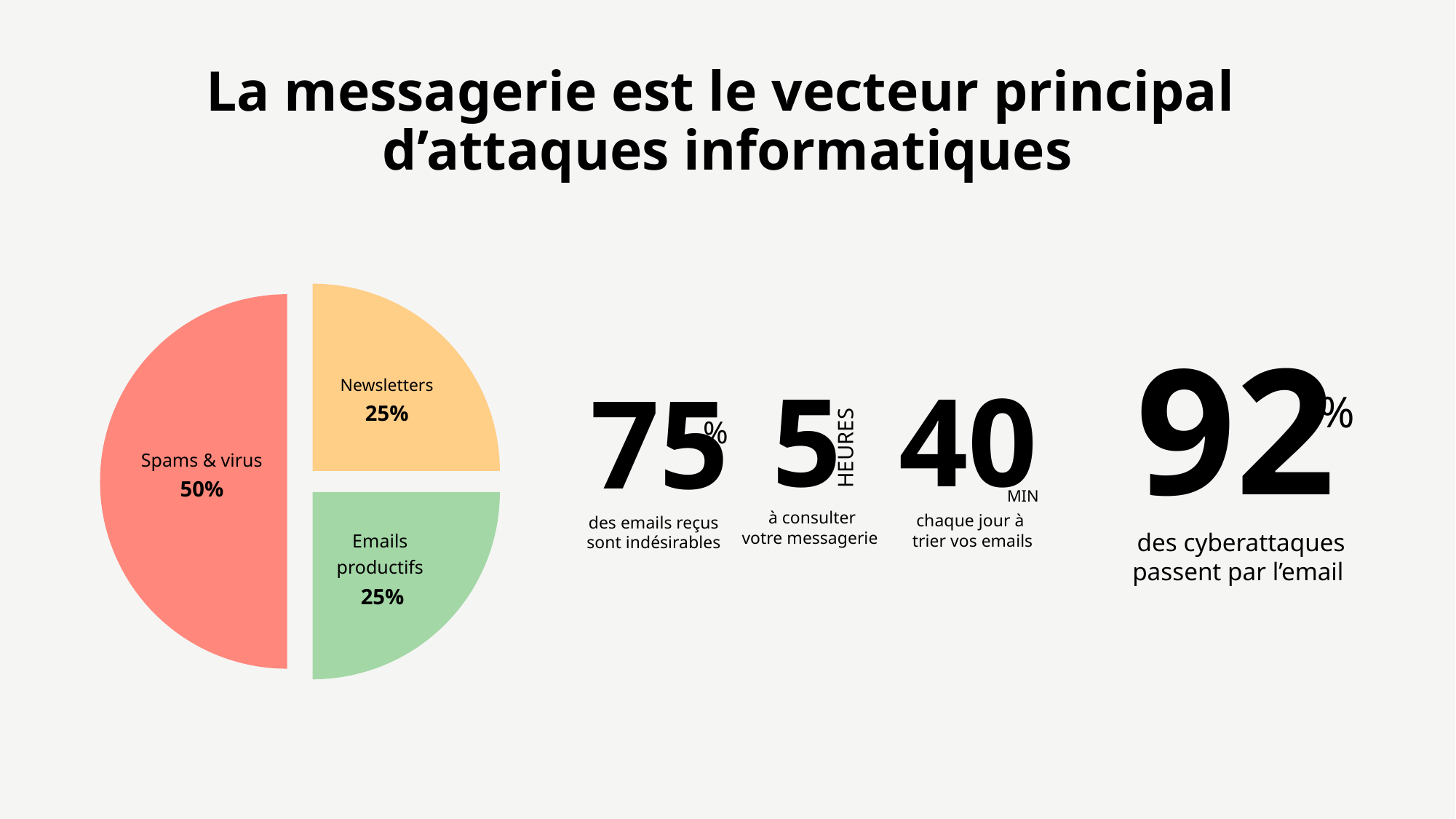
What colour is the Emails productifs slice in the pie chart? green What kind of chart is shown on the slide? pie chart Which slice of the pie chart is the largest? Spams & virus What share of the pie does the Spams & virus slice represent? 50% What is the combined share of Newsletters and Emails productifs in the pie chart? 50% What is the value for Newsletters in the pie chart? 25% What is the value for Emails productifs in the pie chart? 25% Which is larger in the pie chart, Spams & virus or Emails productifs? Spams & virus What is the difference between the Spams & virus slice and the Newsletters slice? 25% What colour is the Spams & virus slice in the pie chart? red What is the value for Spams & virus in the pie chart? 50% How many slices does the pie chart have? 3